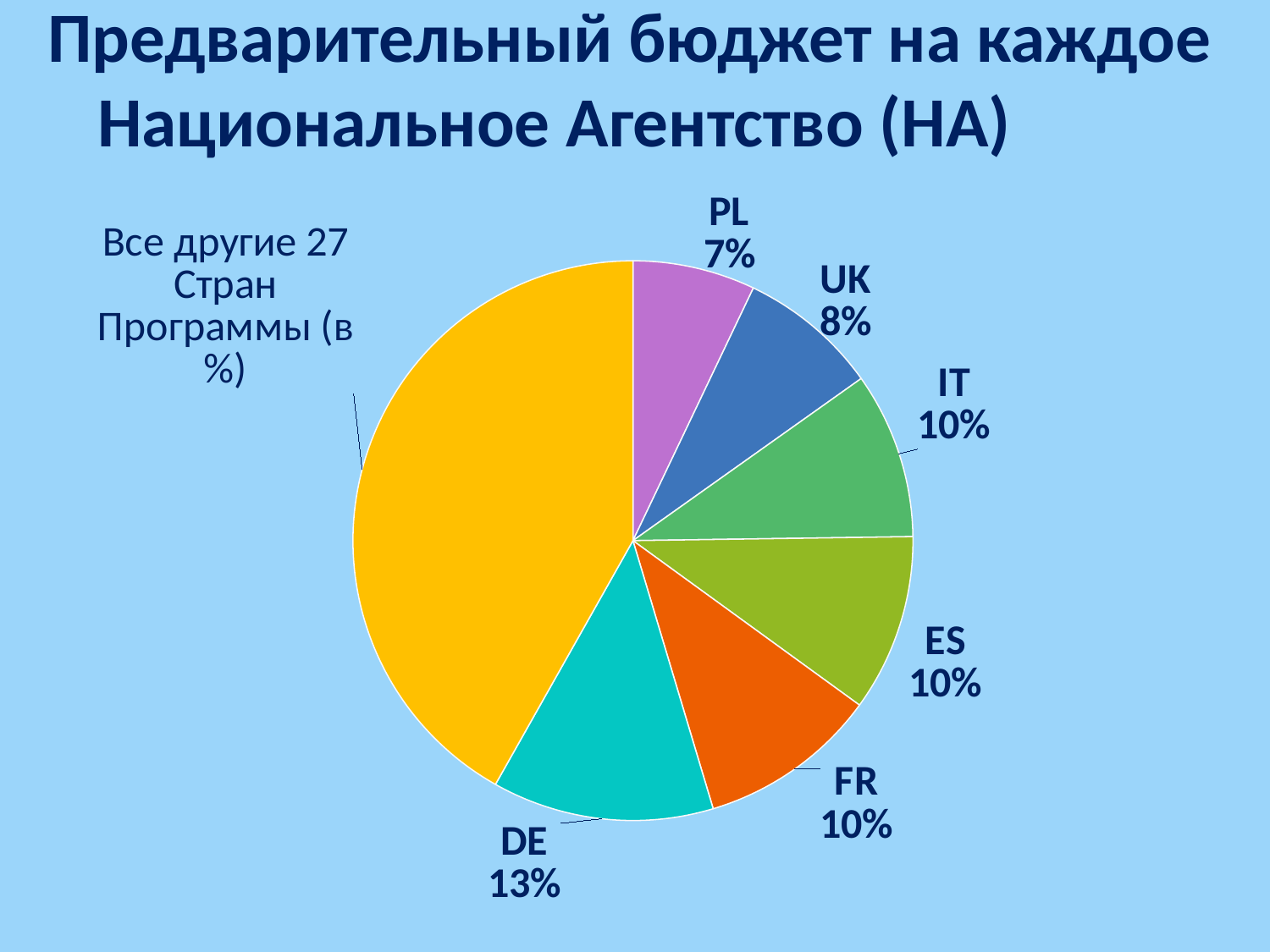
What share of the pie does PL have? 7% Which has a larger share, DE or UK? DE What is the difference in percentage points between DE and PL? 6 What share of the pie does FR have? 10% Which slice of the pie is the largest? Все другие 27 Стран Программы What share of the pie does DE have? 13% How many slices does the pie chart have? 7 Which labelled country has the smallest slice of the pie? PL What is the title of the slide? Предварительный бюджет на каждое Национальное Агентство (НА) What is the difference in percentage points between DE and UK? 5 What kind of chart is shown on the slide? Pie chart What share of the pie does UK have? 8%